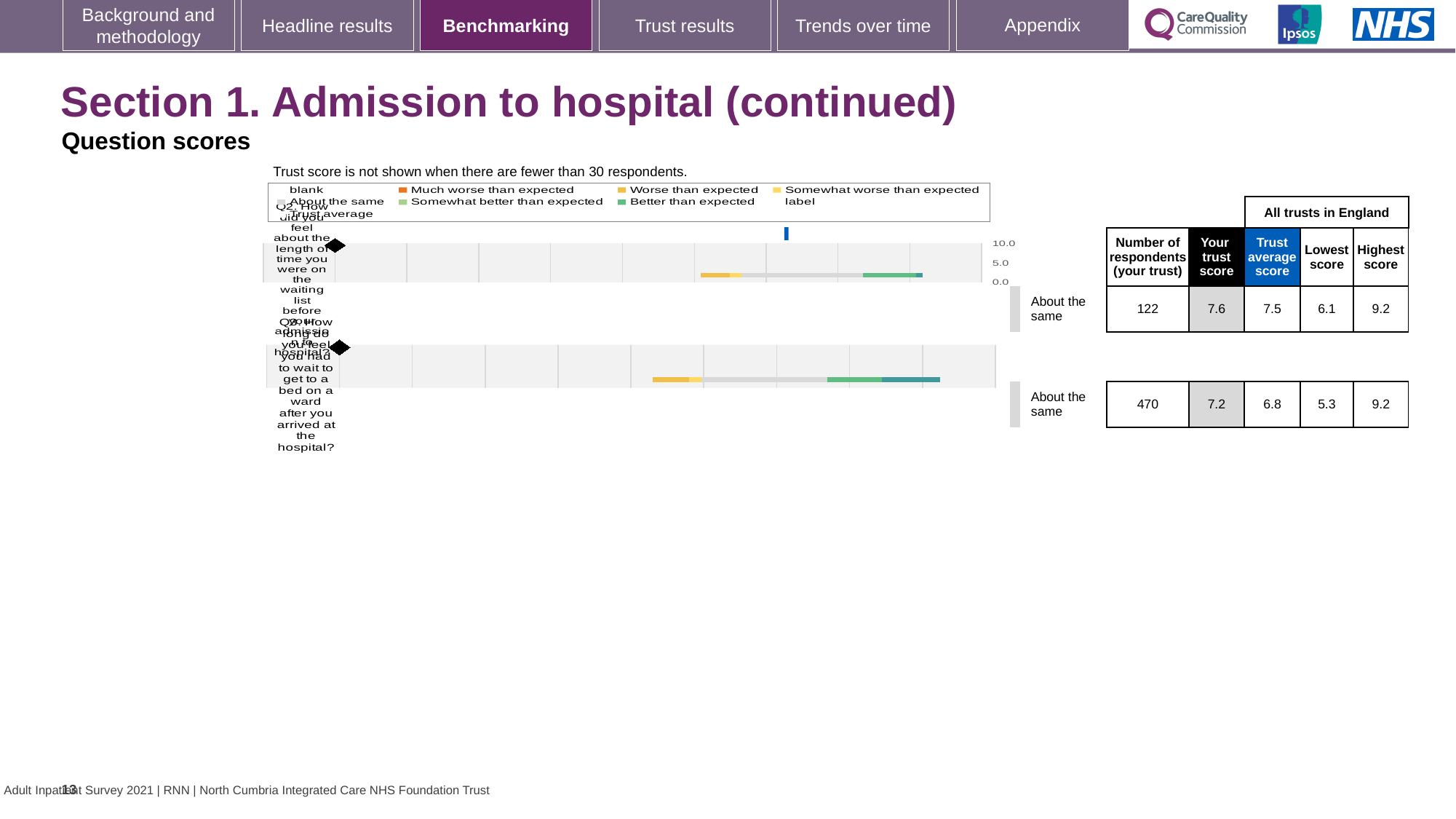
What is the trust score for Q2 (how did you feel about the length of time you were on the waiting list before admission)? 7.6 What is the trust score for Q3 (how long did you feel you had to wait to get to a bed on a ward)? 7.2 What is the lowest score among all trusts in England for Q3? 5.3 How many questions are plotted on the chart? 2 How is the trust's result for Q3 categorised relative to expectations? About the same What is the maximum value shown on the chart's score axis? 10.0 How many respondents from the trust answered Q2? 122 Which question has more respondents from the trust, Q2 or Q3? Q3 What is the difference between the trust score and the trust average score for Q2? 0.1 What is the difference between the highest and lowest scores across all trusts in England for Q3? 3.9 Which question has the higher trust score, Q2 or Q3? Q2 What is the trust average score across all trusts in England for Q3? 6.8